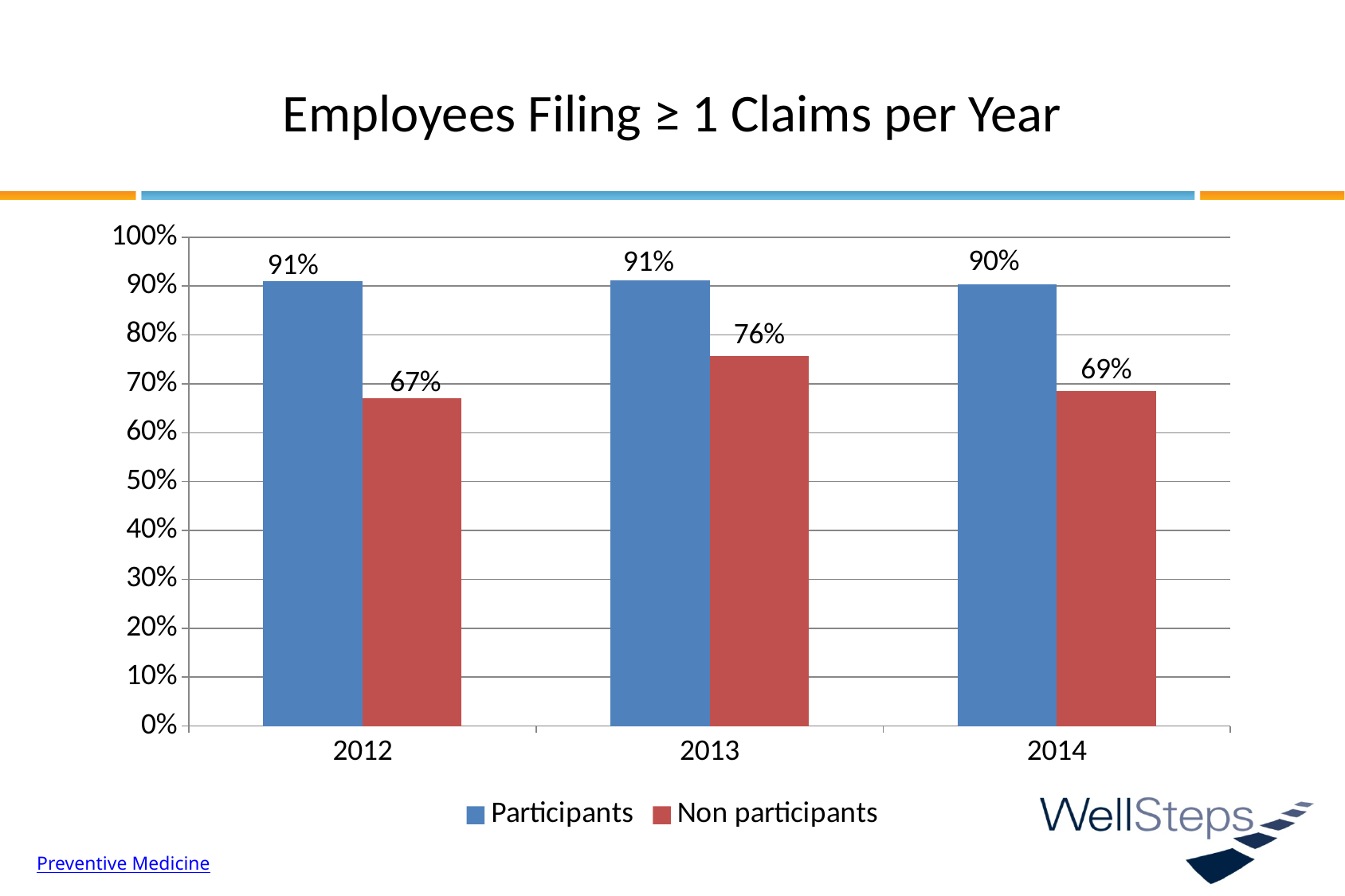
Which group had the larger value in 2013, Participants or Non participants? Participants What is the value for Non participants in 2014? 69% What kind of chart is shown on the slide? Bar chart How many years are shown on the x axis? 3 In which year was the Non participants value highest? 2013 How many series does the legend list? 2 In which year was the Non participants value lowest? 2012 What is the title of the chart? Employees Filing ≥ 1 Claims per Year What percentage of Participants filed ≥ 1 claims in 2012? 91% What is the value for Participants in 2014? 90% What percentage of Non participants filed ≥ 1 claims in 2013? 76% What is the difference between Participants and Non participants in 2012? 24 percentage points